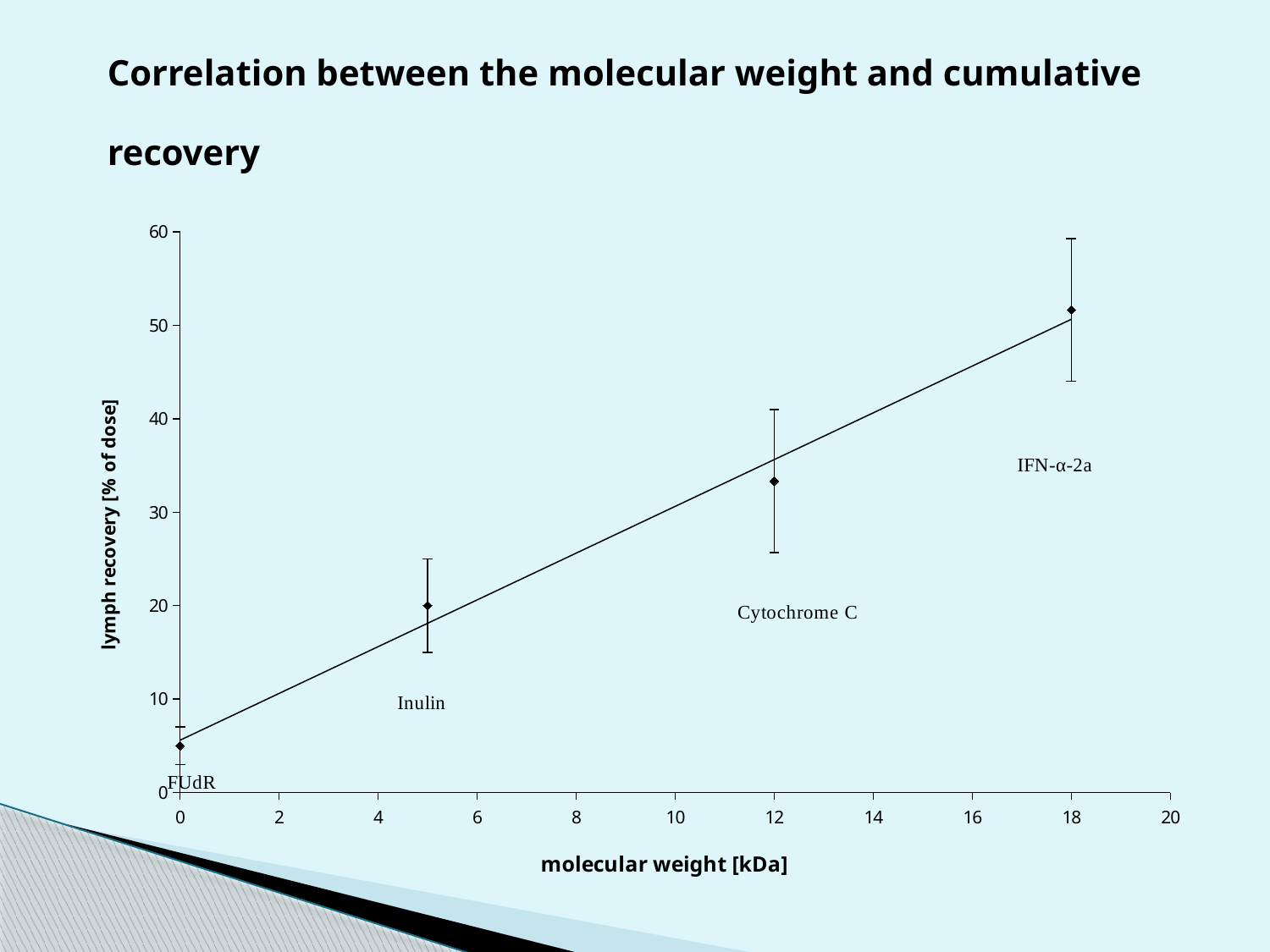
What is the lymph recovery (% of dose) for Inulin? 20 What is the molecular weight of Cytochrome C in kDa according to the x axis? 12 Which compound has the highest lymph recovery? IFN-α-2a What is the molecular weight of IFN-α-2a in kDa according to the x axis? 18 What kind of chart is shown on the slide? scatter chart Is the lymph recovery for Cytochrome C greater or less than 30? greater What is the label of the y axis? lymph recovery [% of dose] Is the lymph recovery for IFN-α-2a greater or less than 50? greater Which compound has the lowest lymph recovery? FUdR Which has a higher lymph recovery, Inulin or Cytochrome C? Cytochrome C Does lymph recovery rise or fall as molecular weight increases? rise How many data points are plotted on the chart? 4